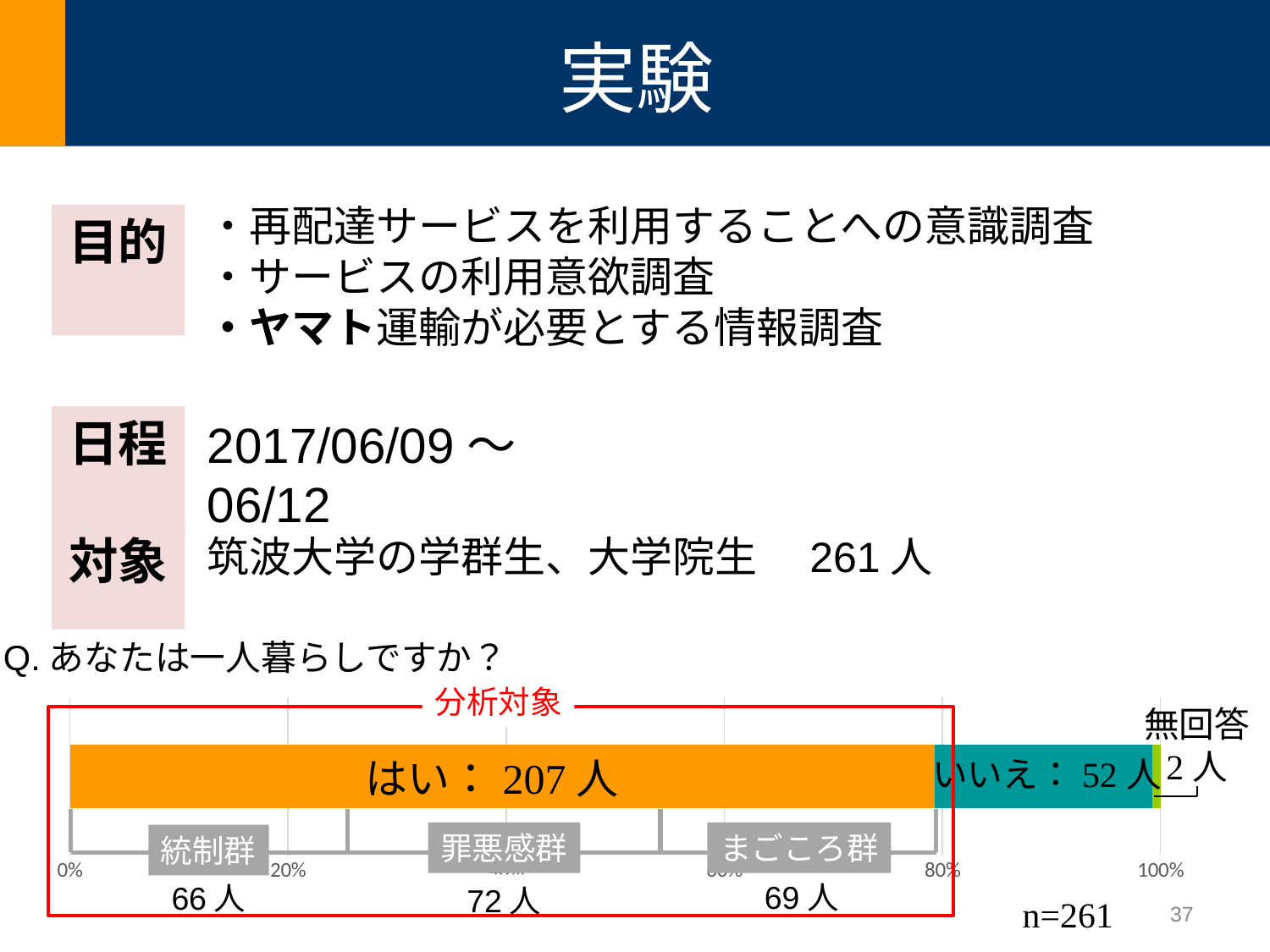
How many respondents answered はい (yes) to the question あなたは一人暮らしですか？? 207 人 What label is written on the red box surrounding the はい segment of the bar chart? 分析対象 How many respondents are shown as 無回答 (no answer) in the bar chart? 2 人 What kind of chart is used to show the responses to あなたは一人暮らしですか？? Stacked horizontal bar chart What is the difference between the number of はい and いいえ respondents? 155 人 Which response category has the smallest number of respondents in the bar chart? 無回答 What is the difference in respondents between the 罪悪感群 and 統制群 groups? 6 人 Which of the three analysis groups (統制群, 罪悪感群, まごころ群) has the most respondents? 罪悪感群 Which response category has the largest number of respondents in the bar chart? はい What is the total number of respondents across all segments of the stacked bar? 261 How many respondents answered いいえ (no) in the bar chart? 52 人 How many respondents are in the 罪悪感群 group? 72 人